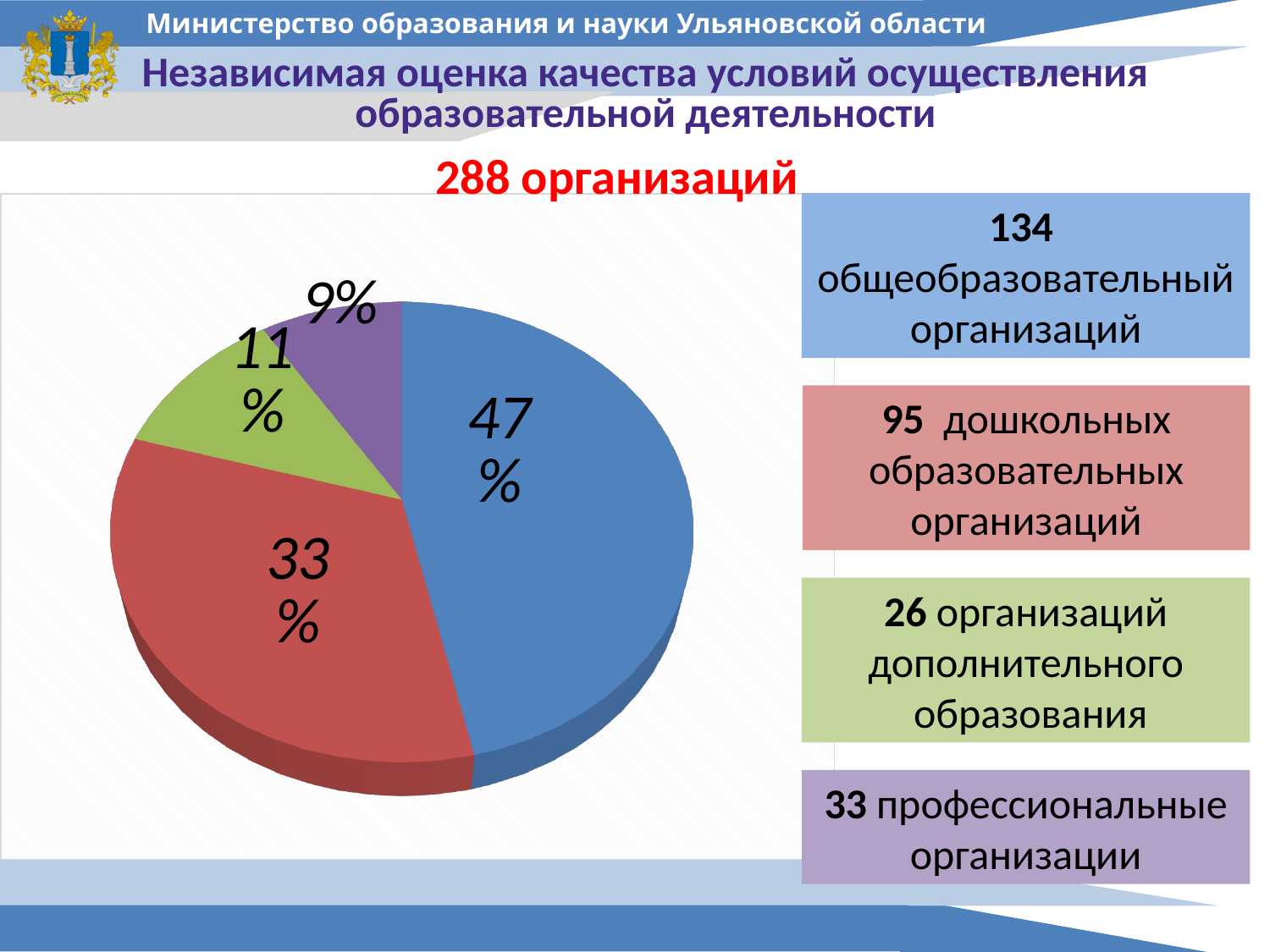
How many organisations in total does the slide say the pie chart covers? 288 организаций What share of the pie does the purple slice represent? 9% What share of the pie does the red slice represent? 33% Which slice of the pie chart is the smallest? 9% (purple) What kind of chart is shown on the slide? pie chart Which slice of the pie chart is the largest? 47% (blue) What is the difference in percentage points between the blue slice and the red slice? 14 How many slices does the pie chart have? 4 What share of the pie does the largest (blue) slice represent? 47% How many общеобразовательных организаций are listed in the blue box next to the chart? 134 Which is larger, the green slice or the purple slice? green (11%)